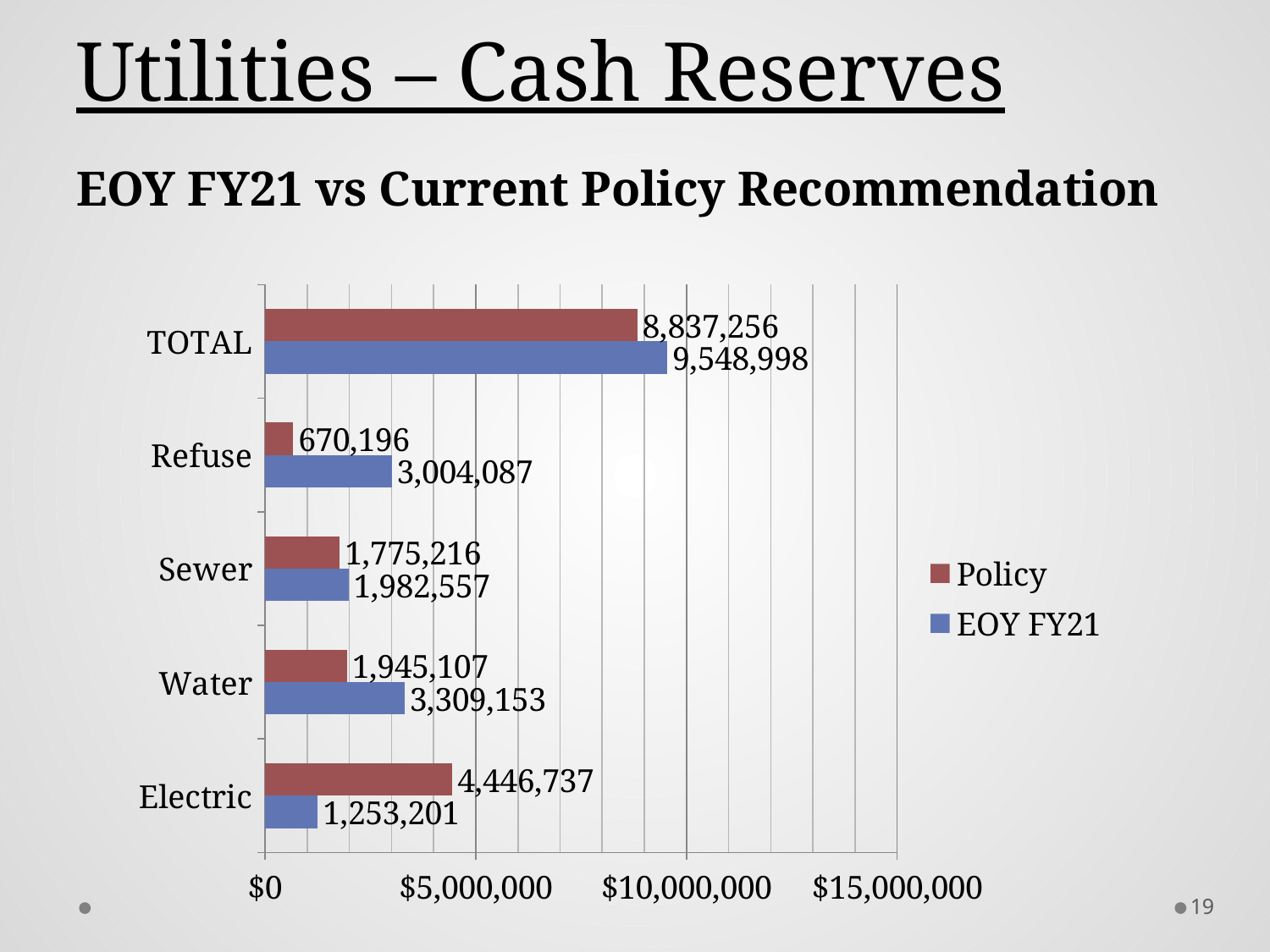
What is the difference between the Policy and EOY FY21 values for Electric? 3,193,536 What is the difference between the EOY FY21 and Policy values for Refuse? 2,333,891 Is the Policy value for Electric greater or less than $5,000,000? less What is the Policy value for Sewer? 1,775,216 How many series does the legend list? 2 What is the Policy value for Electric? 4,446,737 What type of chart is shown on the slide? Bar chart What is the EOY FY21 value for TOTAL? 9,548,998 For Electric, which is larger: the Policy value or the EOY FY21 value? Policy Excluding TOTAL, which category has the highest EOY FY21 value? Water What is the EOY FY21 value for Water? 3,309,153 Which category has the lowest Policy value? Refuse